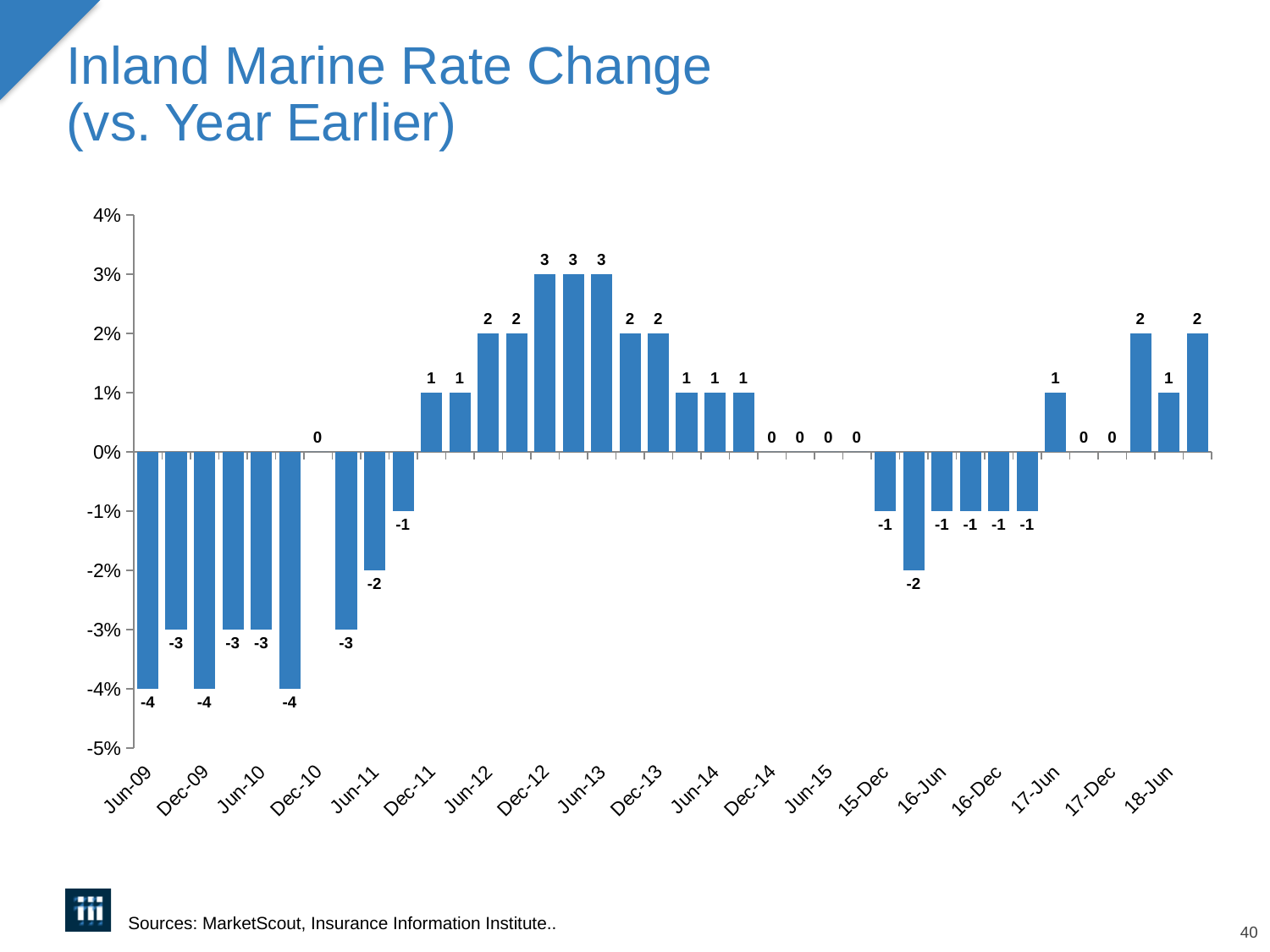
Which has the larger rate change, Dec-09 or Dec-13? Dec-13 What is the Inland Marine rate change for Jun-09? -4 What is the lowest rate change value shown on the chart? -4 What is the title of the chart? Inland Marine Rate Change (vs. Year Earlier) Is the value for Jun-11 greater or less than -1%? less What is the Inland Marine rate change for Dec-12? 3 What is the Inland Marine rate change for 17-Jun? 1 What is the Inland Marine rate change for Dec-10? 0 What is the Inland Marine rate change for 16-Dec? -1 What is the difference between the rate change for Jun-13 and the rate change for Jun-11? 5 What kind of chart is shown on the slide? Bar chart What is the highest rate change value shown on the chart? 3